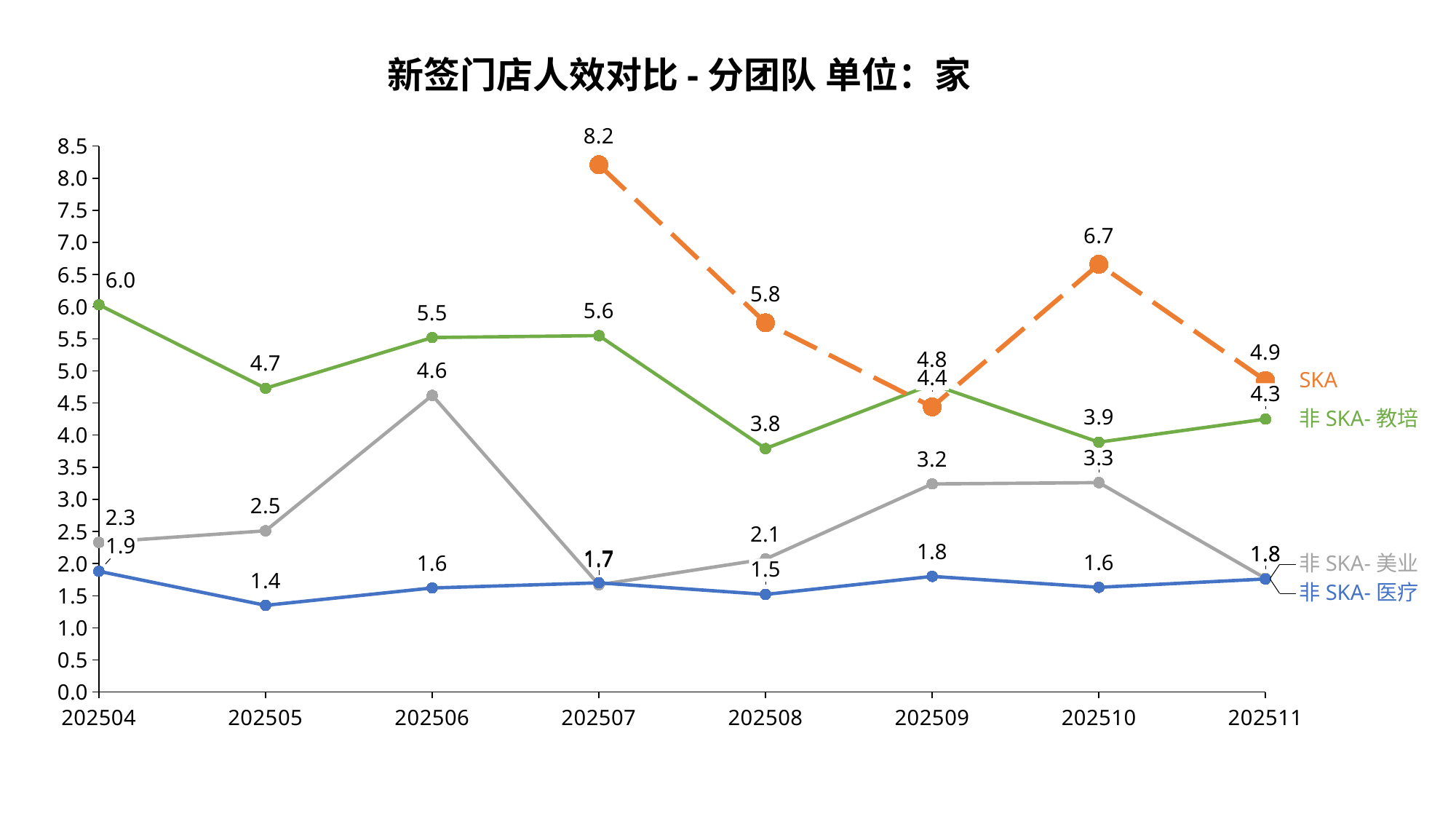
What is the value for 非SKA-医疗 at 202505? 1.4 Which series is drawn with a dashed line? SKA What is the value for 非SKA-美业 at 202506? 4.6 Which is larger at 202509, SKA or 非SKA-教培? 非SKA-教培 What is the value for 非SKA-教培 at 202504? 6.0 What kind of chart is this? Line chart At which month is 非SKA-教培 at its lowest value? 202508 What is the difference between SKA and 非SKA-教培 at 202510? 2.8 How many months are shown on the x axis? 8 How many series are plotted on the chart? 4 At which month does SKA reach its highest value? 202507 What is the value for SKA at 202507? 8.2